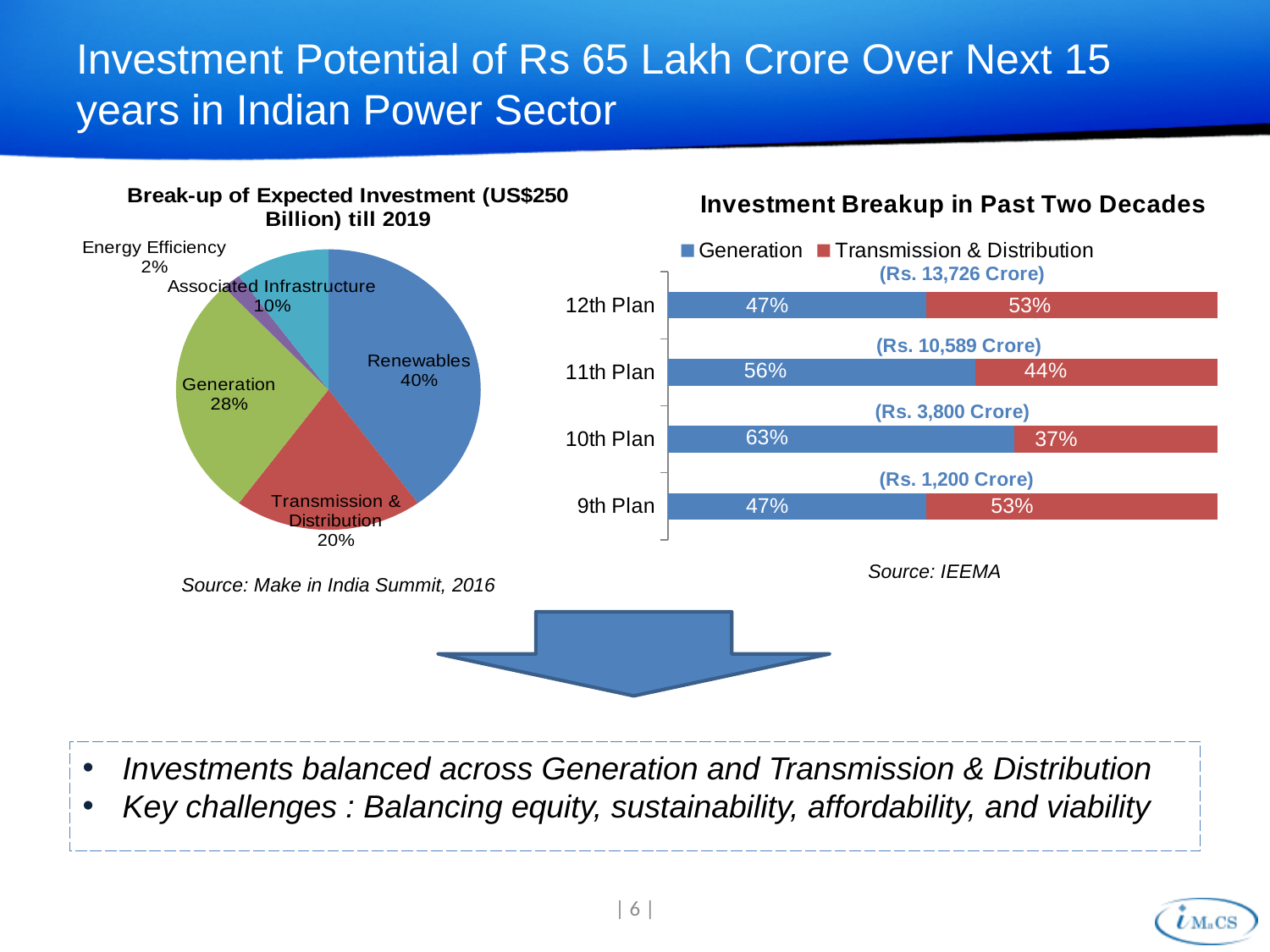
In the pie chart 'Break-up of Expected Investment (US$250 Billion) till 2019', what is the difference in percentage points between Generation and Transmission & Distribution? 8 percentage points In the pie chart 'Break-up of Expected Investment (US$250 Billion) till 2019', which is larger: Associated Infrastructure or Energy Efficiency? Associated Infrastructure In the chart 'Investment Breakup in Past Two Decades', what is the Transmission & Distribution share for the 10th Plan? 37% What kind of chart is 'Investment Breakup in Past Two Decades'? Stacked bar chart In the pie chart 'Break-up of Expected Investment (US$250 Billion) till 2019', which category has the smallest share? Energy Efficiency In the chart 'Investment Breakup in Past Two Decades', what total investment amount is shown for the 12th Plan? Rs. 13,726 Crore In the chart 'Investment Breakup in Past Two Decades', what is the Generation share for the 11th Plan? 56% In the pie chart 'Break-up of Expected Investment (US$250 Billion) till 2019', how many slices are there? 5 In the chart 'Investment Breakup in Past Two Decades', which plan has the highest Generation share? 10th Plan In the pie chart 'Break-up of Expected Investment (US$250 Billion) till 2019', what share does Renewables have? 40% In the pie chart 'Break-up of Expected Investment (US$250 Billion) till 2019', which category has the largest share? Renewables In the chart 'Investment Breakup in Past Two Decades', how many series does the legend list? 2